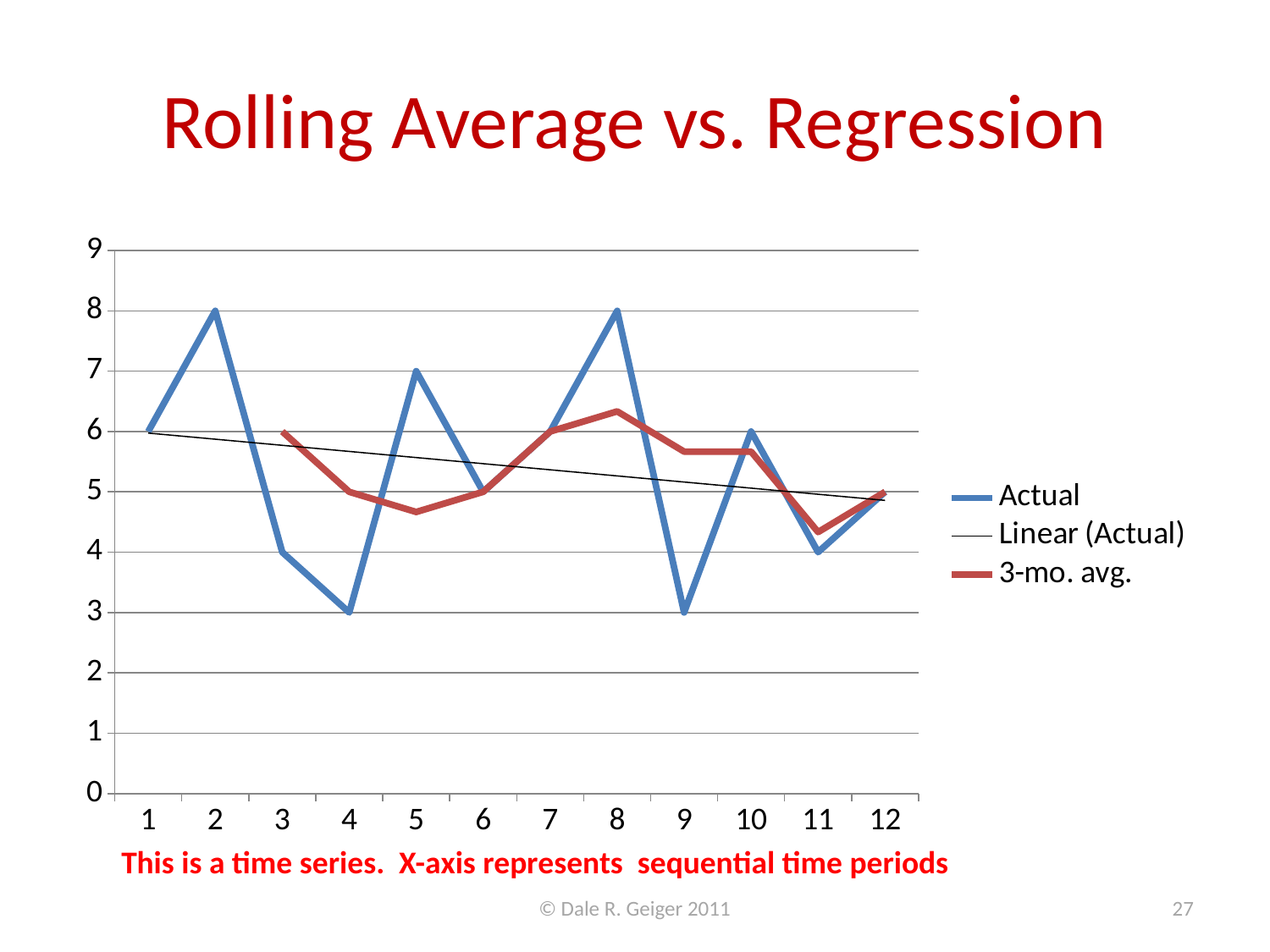
What is the title of the chart on the slide? Rolling Average vs. Regression Is the 3-mo. avg. value at period 8 greater or less than 6? greater What is the highest value reached by the Actual series? 8 How many series does the legend list? 3 How many time periods are shown on the x axis? 12 What type of chart is shown on the slide? line chart What is the Actual value at period 4? 3 Which is larger, the Actual value at period 5 or the Actual value at period 6? period 5 What is the Actual value at period 9? 3 What is the difference between the Actual value at period 8 and the Actual value at period 9? 5 What is the Actual value at period 2? 8 Does the Linear (Actual) trend line rise or fall from period 1 to period 12? fall